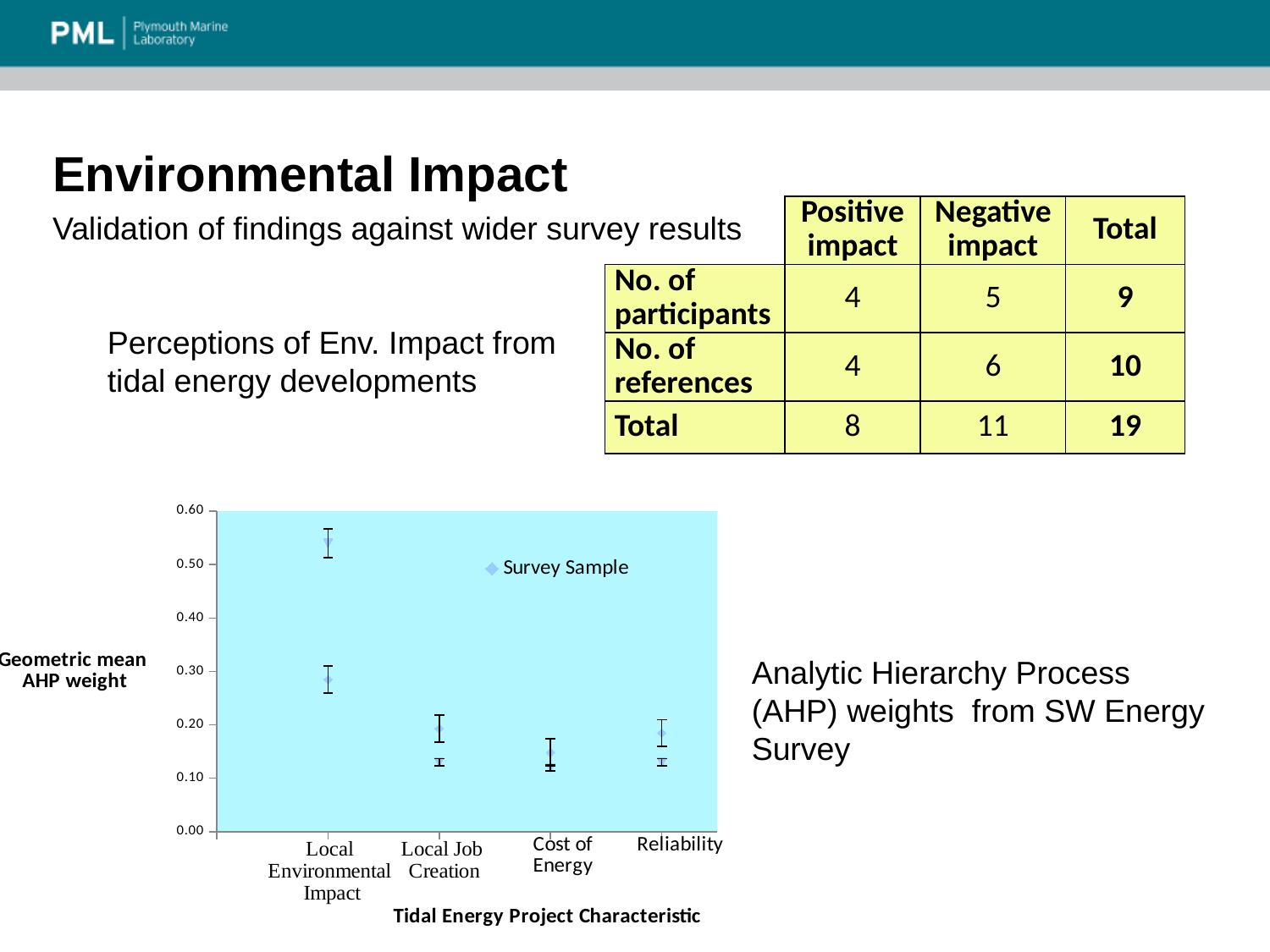
Which has a larger plotted value, Local Environmental Impact or Cost of Energy? Local Environmental Impact Is the value for Reliability greater or less than 0.30? less How many categories are shown on the x axis of the chart? 4 Is the value for Cost of Energy greater or less than 0.10? greater What kind of chart is shown on the slide? scatter chart How many series does the chart legend list? 1 What is the name of the series listed in the chart legend? Survey Sample Is the highest plotted value for Local Environmental Impact greater or less than 0.50? greater What is the title of the x axis of the chart? Tidal Energy Project Characteristic Which category has the highest plotted value in the chart? Local Environmental Impact